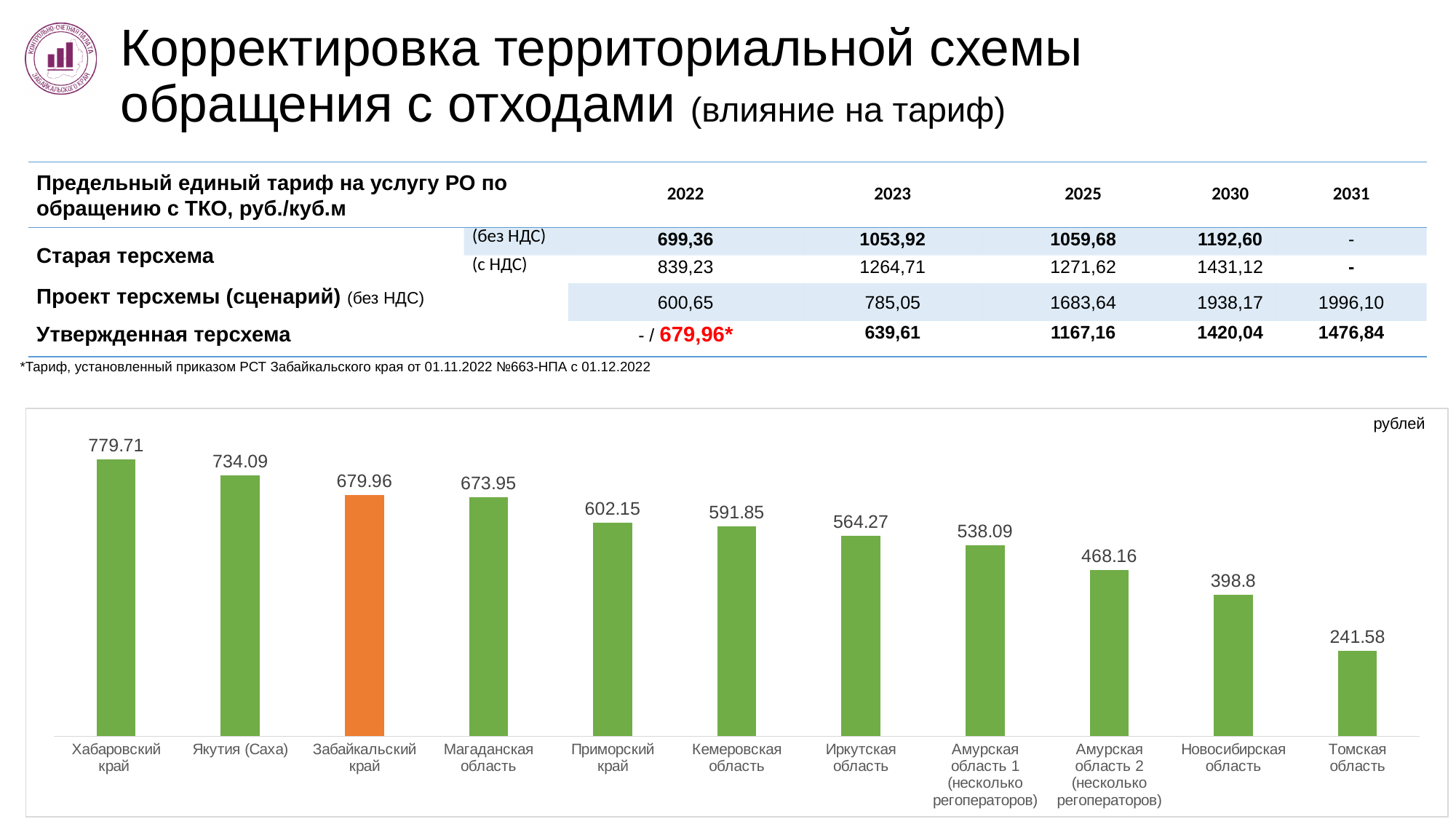
What is the difference between the values for Якутия (Саха) and Забайкальский край? 54.13 What type of chart is shown on the slide? bar chart Which region has the highest value in the chart? Хабаровский край What is the difference between the values for Хабаровский край and Томская область? 538.13 Do the values rise or fall from left to right along the x axis? fall Which region has the lowest value in the chart? Томская область Which region's bar is coloured orange instead of green? Забайкальский край Which has a larger value, Приморский край or Иркутская область? Приморский край What is the value for Хабаровский край in the chart? 779.71 What is the value for Новосибирская область in the chart? 398.8 How many regions (bars) are shown in the chart? 11 What is the value for Забайкальский край in the chart? 679.96